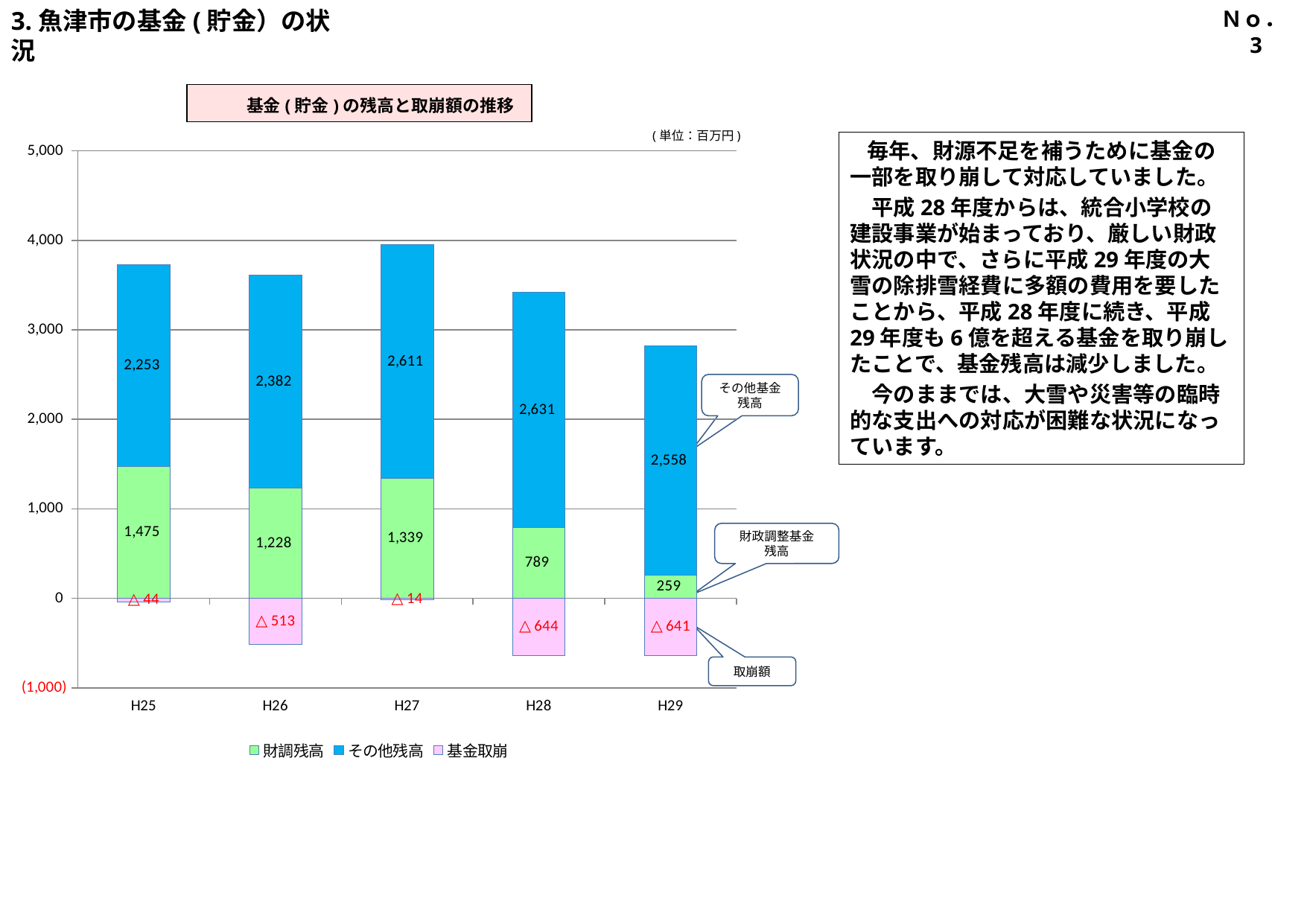
Which year has the lowest 財調残高? H29 Which year has the highest その他残高? H28 Does the 財調残高 rise or fall from H27 to H29? Fall What is the 基金取崩 value shown for H26? △ 513 What is the 財調残高 value for H25? 1,475 What is the その他残高 value for H28? 2,631 What is the difference between the 財調残高 for H27 and H28? 550 Which is larger, the 財調残高 for H25 or for H26? H25 What is the combined total of 財調残高 and その他残高 for H29? 2,817 What kind of chart is shown? Stacked bar chart How many series does the legend list? 3 How many years are shown on the x axis? 5